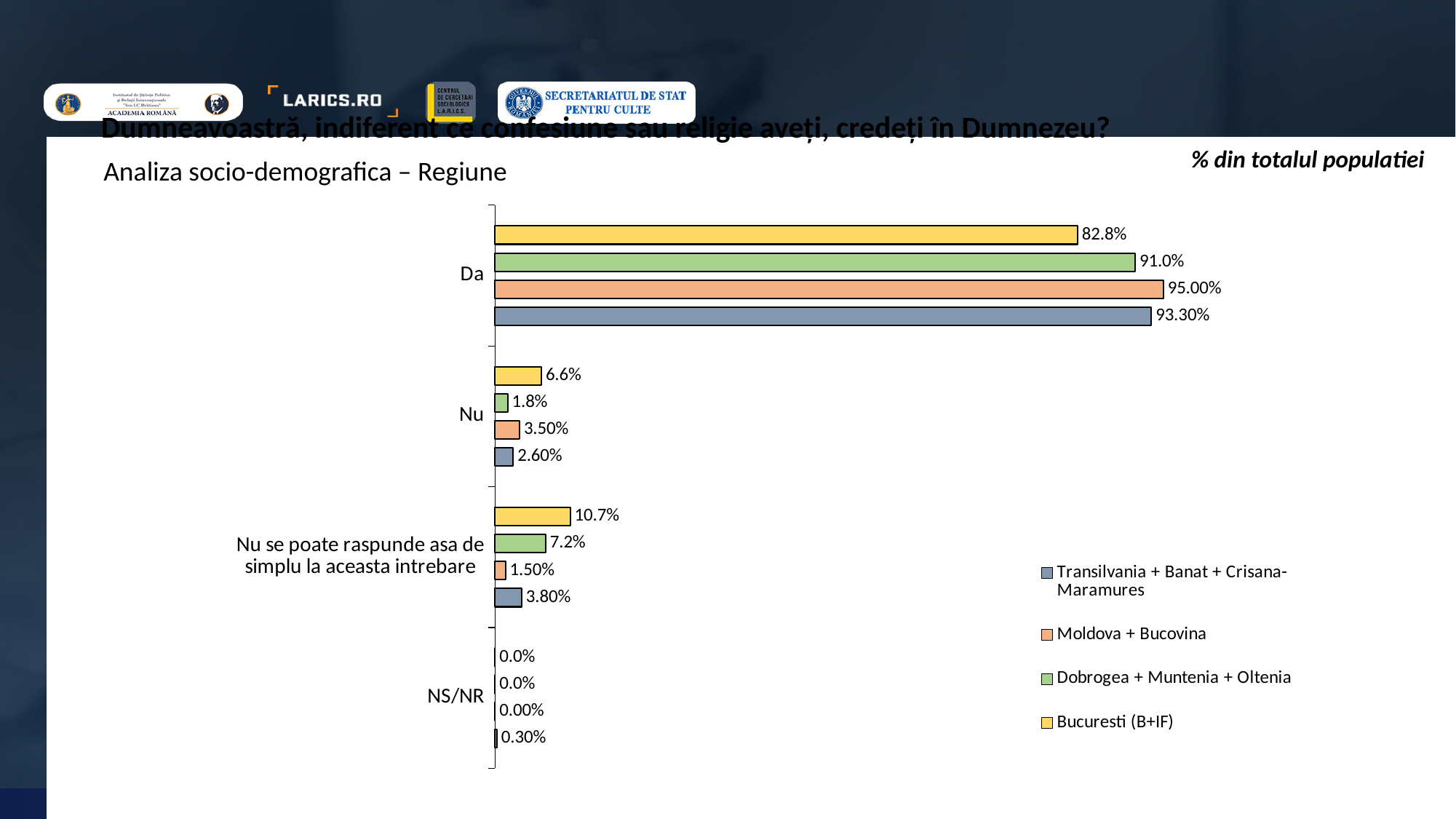
What is the value for Transilvania + Banat + Crisana-Maramures in the 'NS/NR' category? 0.30% What is the difference between Moldova + Bucovina and Bucuresti (B+IF) in the 'Da' category? 12.2% How many series does the legend list? 4 Which region has the highest value in the 'Nu se poate raspunde asa de simplu la aceasta intrebare' category? Bucuresti (B+IF) How many answer categories are shown on the chart? 4 Which region has the highest value in the 'Da' category? Moldova + Bucovina Which region has the lowest value in the 'Da' category? Bucuresti (B+IF) What is the value for Bucuresti (B+IF) in the 'Da' category? 82.8% In the 'Nu' category, which is larger: Bucuresti (B+IF) or Moldova + Bucovina? Bucuresti (B+IF) What is the value for Dobrogea + Muntenia + Oltenia in the 'Nu' category? 1.8% What kind of chart is shown on the slide? bar chart What is the value for Moldova + Bucovina in the 'Da' category? 95.00%